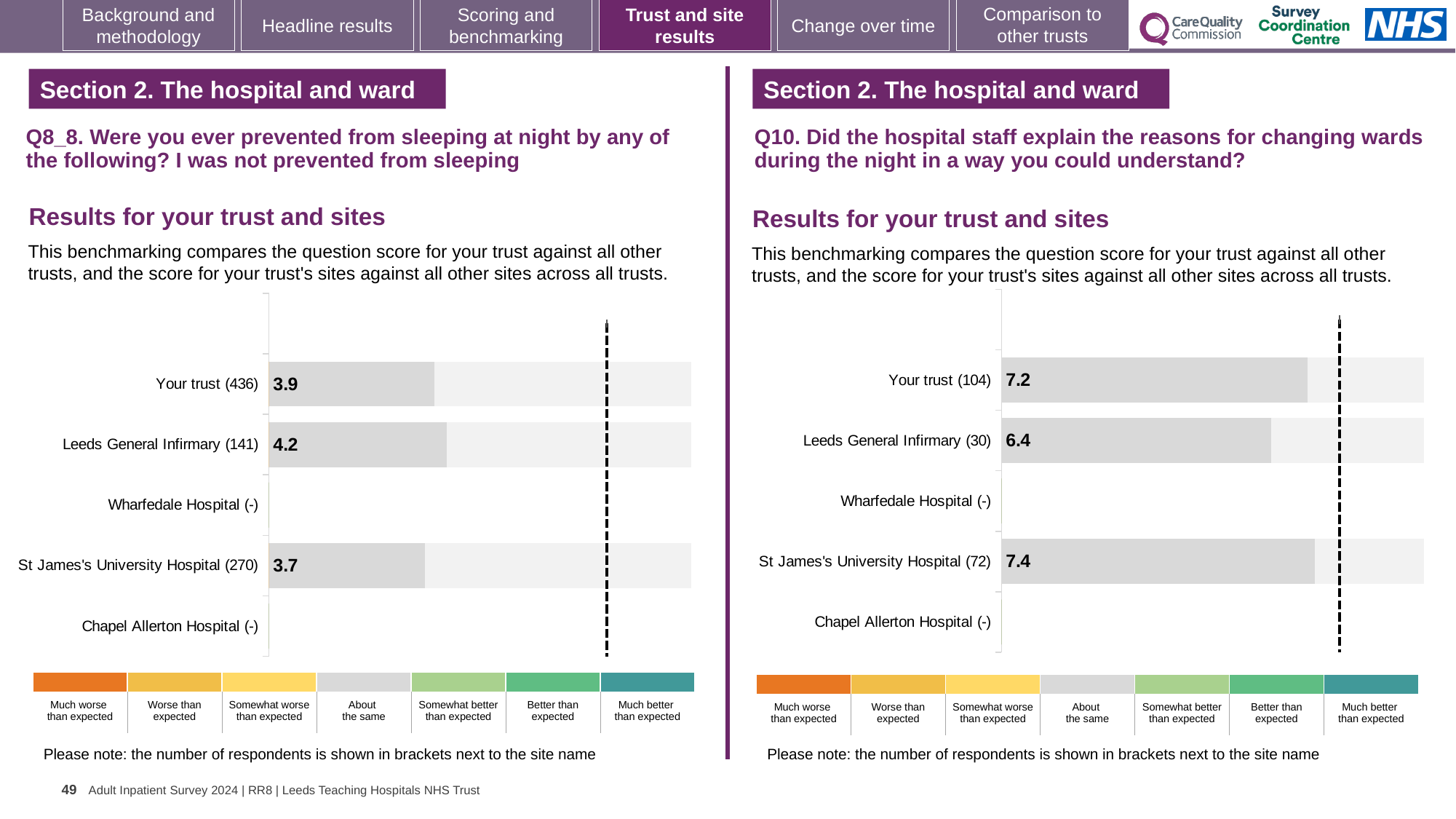
In the Q8_8 chart on the left, what is the difference between the scores for Leeds General Infirmary and St James's University Hospital? 0.5 In the Q8_8 chart on the left, what is the score for Leeds General Infirmary? 4.2 In the Q8_8 chart on the left, what is the score for St James's University Hospital? 3.7 In the Q10 chart on the right, which site with a plotted score has the lowest value? Leeds General Infirmary In the Q10 chart on the right, what is the difference between the scores for Your trust and Leeds General Infirmary? 0.8 In the Q10 chart on the right, what is the score for Leeds General Infirmary? 6.4 In the Q10 chart on the right, what is the score for St James's University Hospital? 7.4 In the Q10 chart on the right, is the score for St James's University Hospital larger or smaller than the score for Your trust? larger In the Q10 chart on the right, what is the score for Your trust? 7.2 In the Q8_8 chart on the left, what is the score for Your trust? 3.9 In the Q8_8 chart on the left, which site with a plotted score has the highest value? Leeds General Infirmary What kind of chart is used in the Q8_8 chart on the left? bar chart